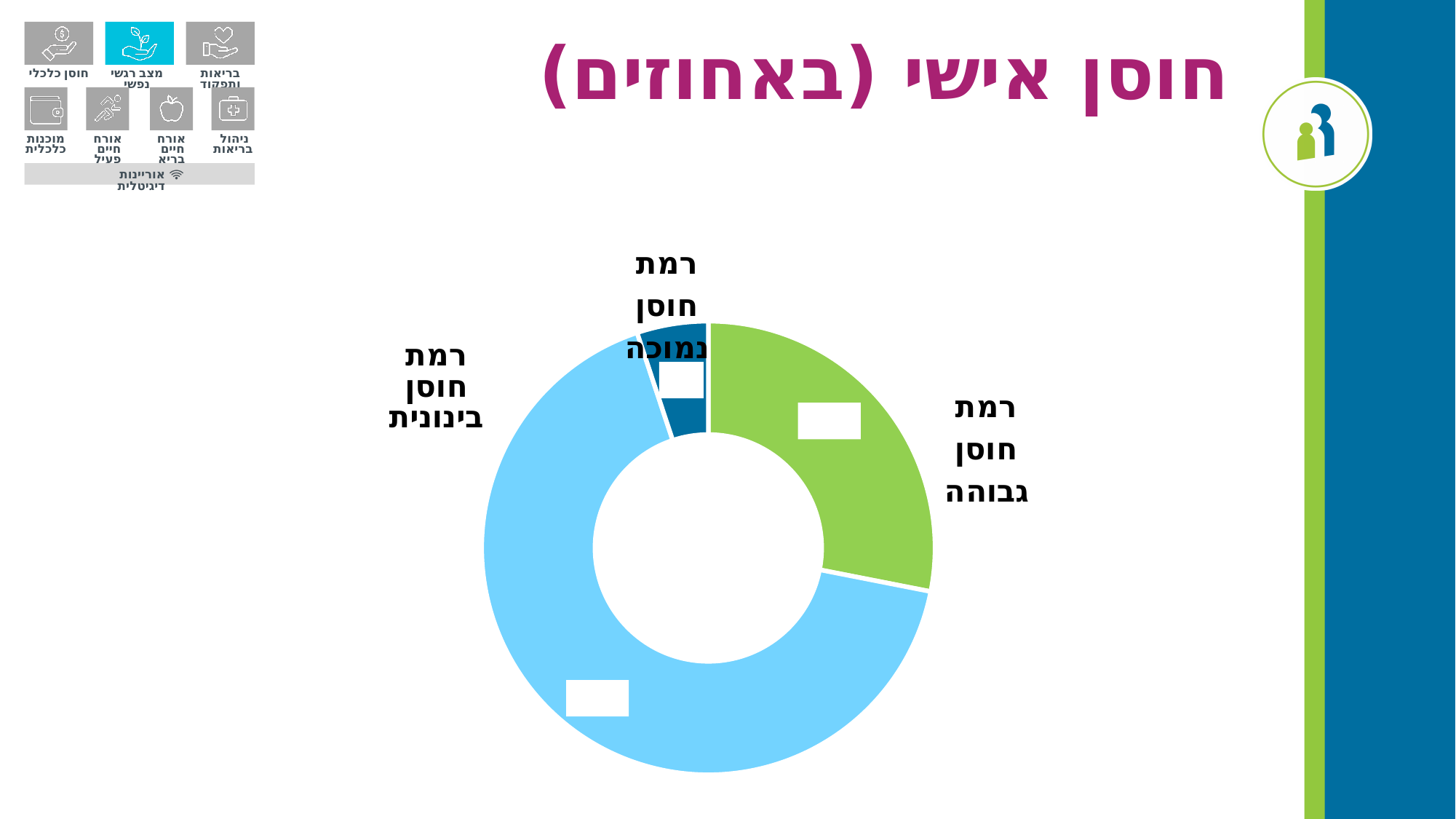
What is the title of the chart on the slide? חוסן אישי (באחוזים) Is the slice for רמת חוסן בינונית more or less than half of the chart? More What kind of chart is shown on the slide? Pie chart (donut) Which slice is larger: רמת חוסן גבוהה or רמת חוסן נמוכה? רמת חוסן גבוהה What colour is the slice for רמת חוסן גבוהה? Green Is the slice for רמת חוסן גבוהה more or less than half of the chart? Less Which category has the largest slice of the chart? רמת חוסן בינונית Which slice is larger: רמת חוסן בינונית or רמת חוסן גבוהה? רמת חוסן בינונית How many categories (slices) does the chart have? 3 Which category has the smallest slice of the chart? רמת חוסן נמוכה